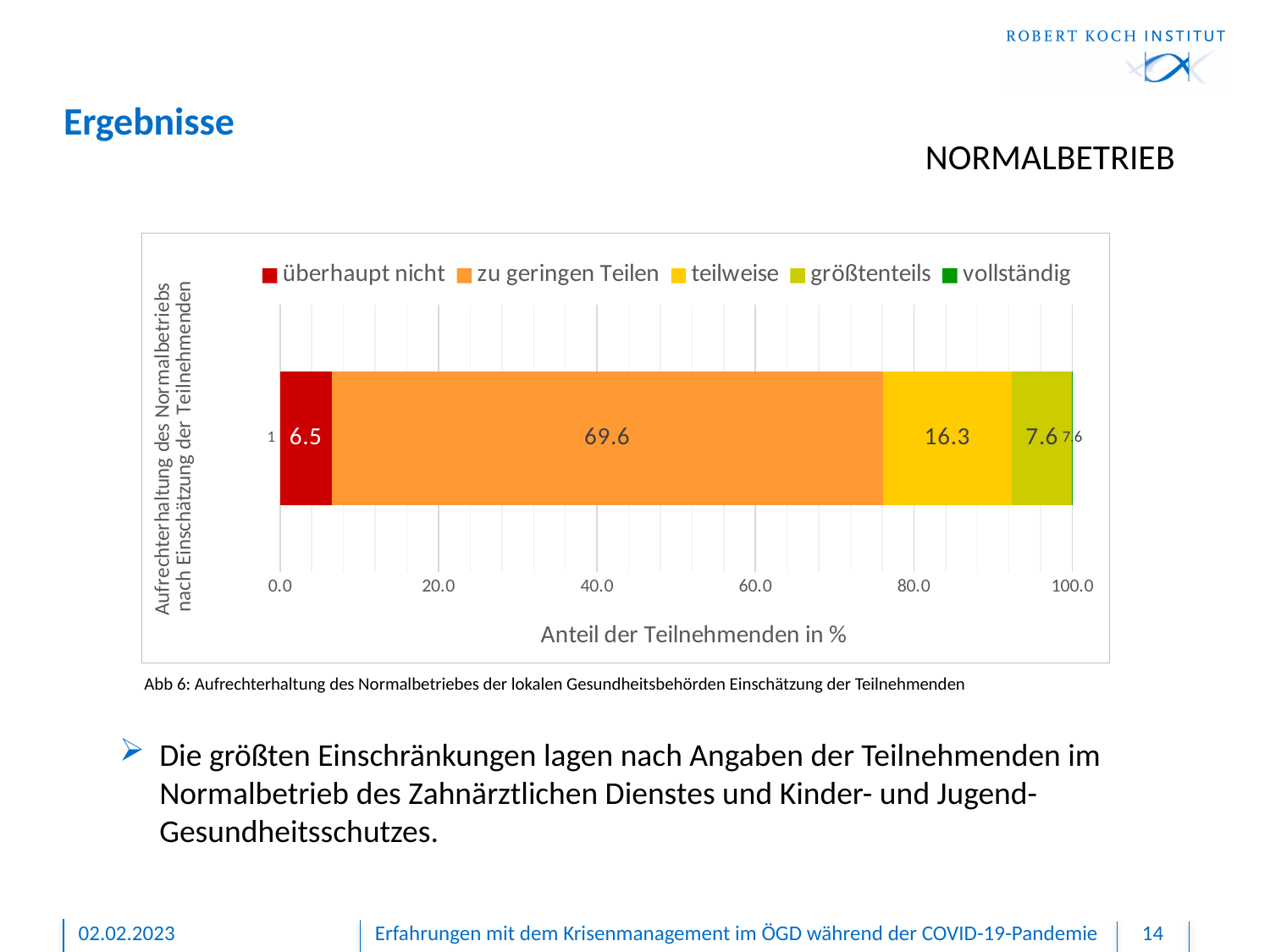
What is the title of the horizontal axis? Anteil der Teilnehmenden in % What kind of chart is shown on the slide? stacked bar chart What is the difference between the values for "teilweise" and "größtenteils"? 8.7 Which response category has the largest share of the bar? zu geringen Teilen What is the value for "größtenteils"? 7.6 What is the difference between the values for "zu geringen Teilen" and "teilweise"? 53.3 Which is larger, the value for "überhaupt nicht" or for "größtenteils"? größtenteils What value is printed on the "teilweise" segment of the bar? 16.3 What is the value shown for the "überhaupt nicht" segment? 6.5 How many series does the legend list? 5 What percentage of participants answered "zu geringen Teilen"? 69.6